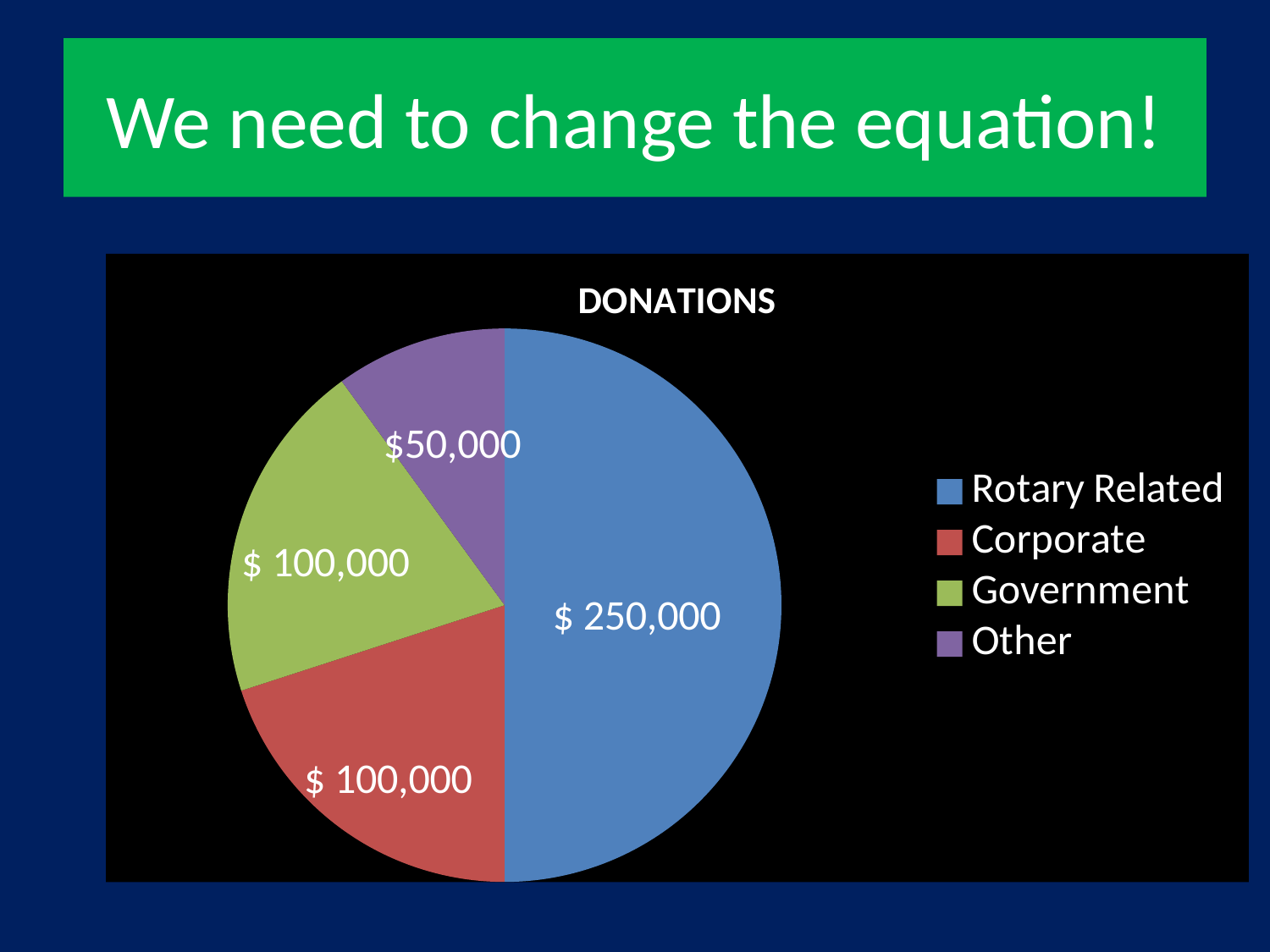
What is the value of the Corporate slice in the DONATIONS pie chart? $ 100,000 What is the value of the Other slice in the DONATIONS pie chart? $50,000 What is the title of the chart on the slide? DONATIONS What is the value of the Rotary Related slice in the DONATIONS pie chart? $ 250,000 What type of chart is shown on the slide? Pie chart Which is larger in the DONATIONS pie chart, Rotary Related or Corporate? Rotary Related Which category has the largest slice in the DONATIONS pie chart? Rotary Related What is the difference between the Rotary Related and Other values in the DONATIONS pie chart? $200,000 What share of the total donations does the Rotary Related slice represent? 50% How many slices does the DONATIONS pie chart have? 4 Which category has the smallest slice in the DONATIONS pie chart? Other What is the value of the Government slice in the DONATIONS pie chart? $ 100,000